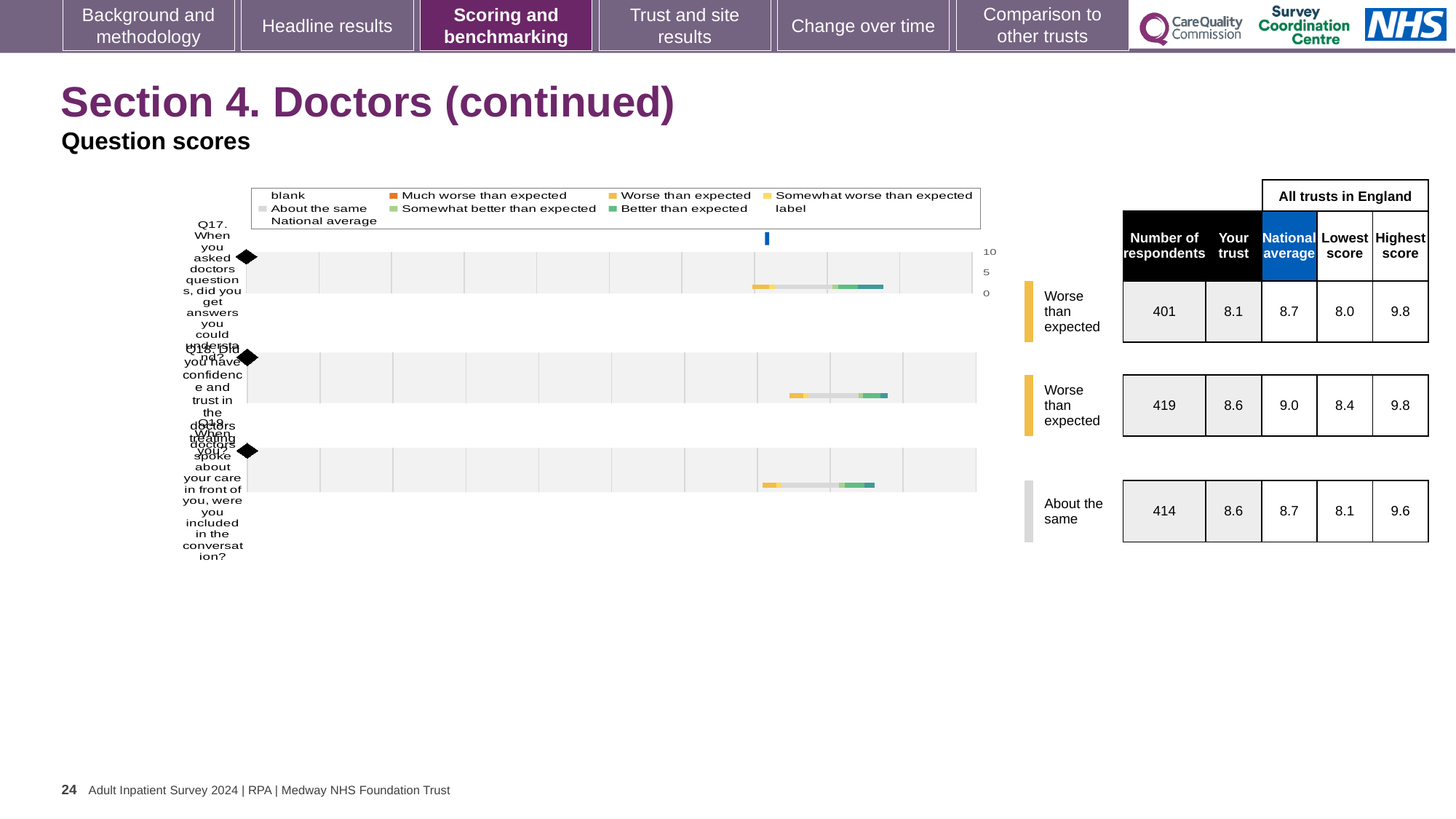
How many questions are plotted in the chart? 3 How many respondents are listed for Q17 in the table beside the chart? 401 What is the lowest score across all trusts in England for Q17? 8.0 What benchmark category is shown for Q19? About the same What is the difference between the national average and the 'Your trust' score for Q18? 0.4 Which question has the lowest 'Your trust' score? Q17 Which question has the fewest respondents? Q17 For Q17, which is larger: the 'Your trust' score or the national average? National average What is the national average score for Q19 (doctors speaking about your care in front of you)? 8.7 What type of chart is shown on the slide? Bar chart What is the highest score across all trusts in England for Q18? 9.8 What is the 'Your trust' score for Q18 (confidence and trust in the doctors treating you)? 8.6